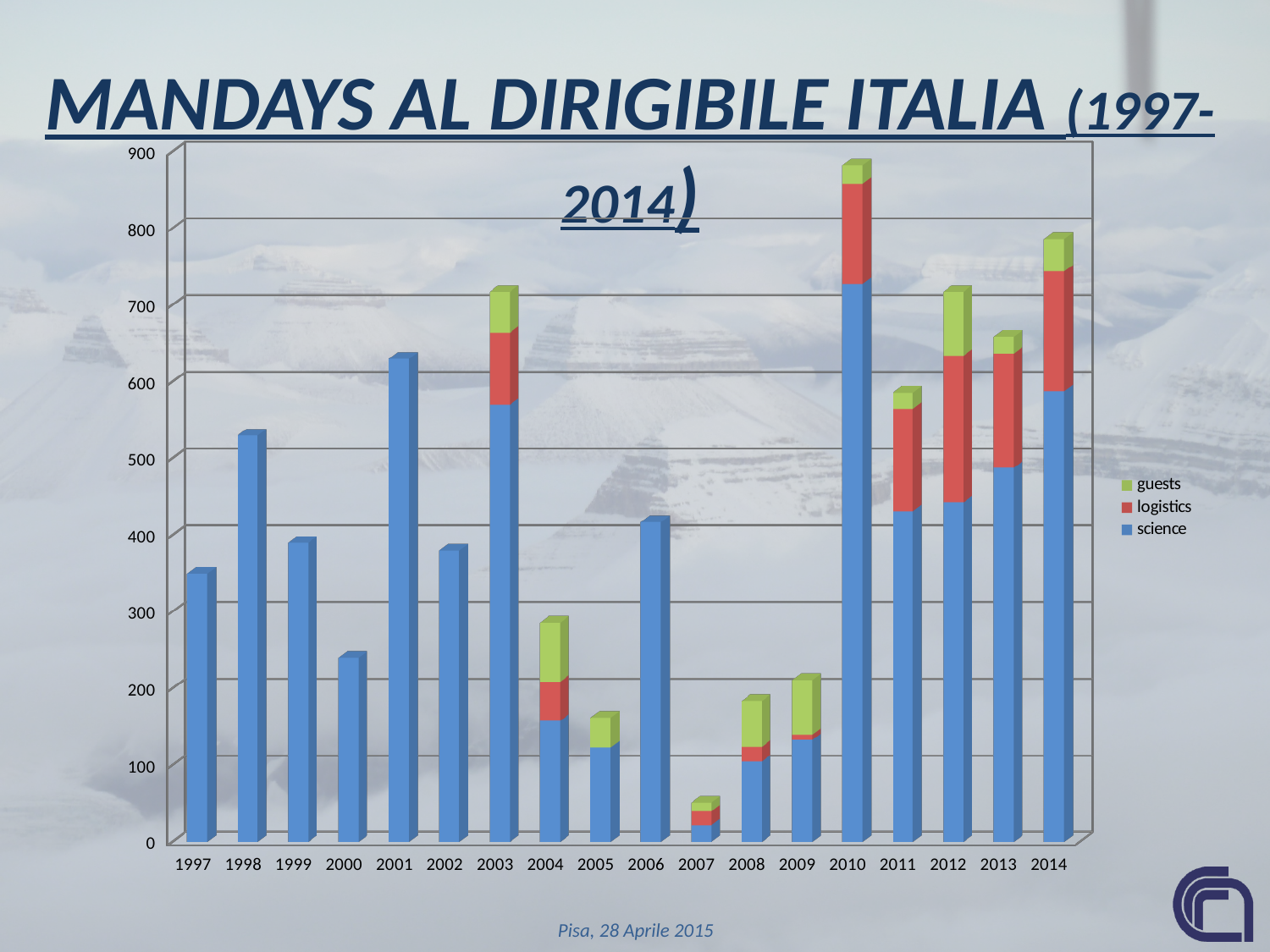
How many series does the legend list? 3 What are the three series listed in the legend? guests, logistics, science Is the total value for 2010 greater or less than 800? greater Is the value for 2001 greater or less than 600? greater Is the total value for 2007 greater or less than 100? less What kind of chart is shown on the slide? bar chart Which series is shown in blue in the legend? science Which year has the larger bar, 1999 or 2001? 2001 Which year has the lowest total bar? 2007 How many years are shown along the x axis? 18 Which year has the highest total bar? 2010